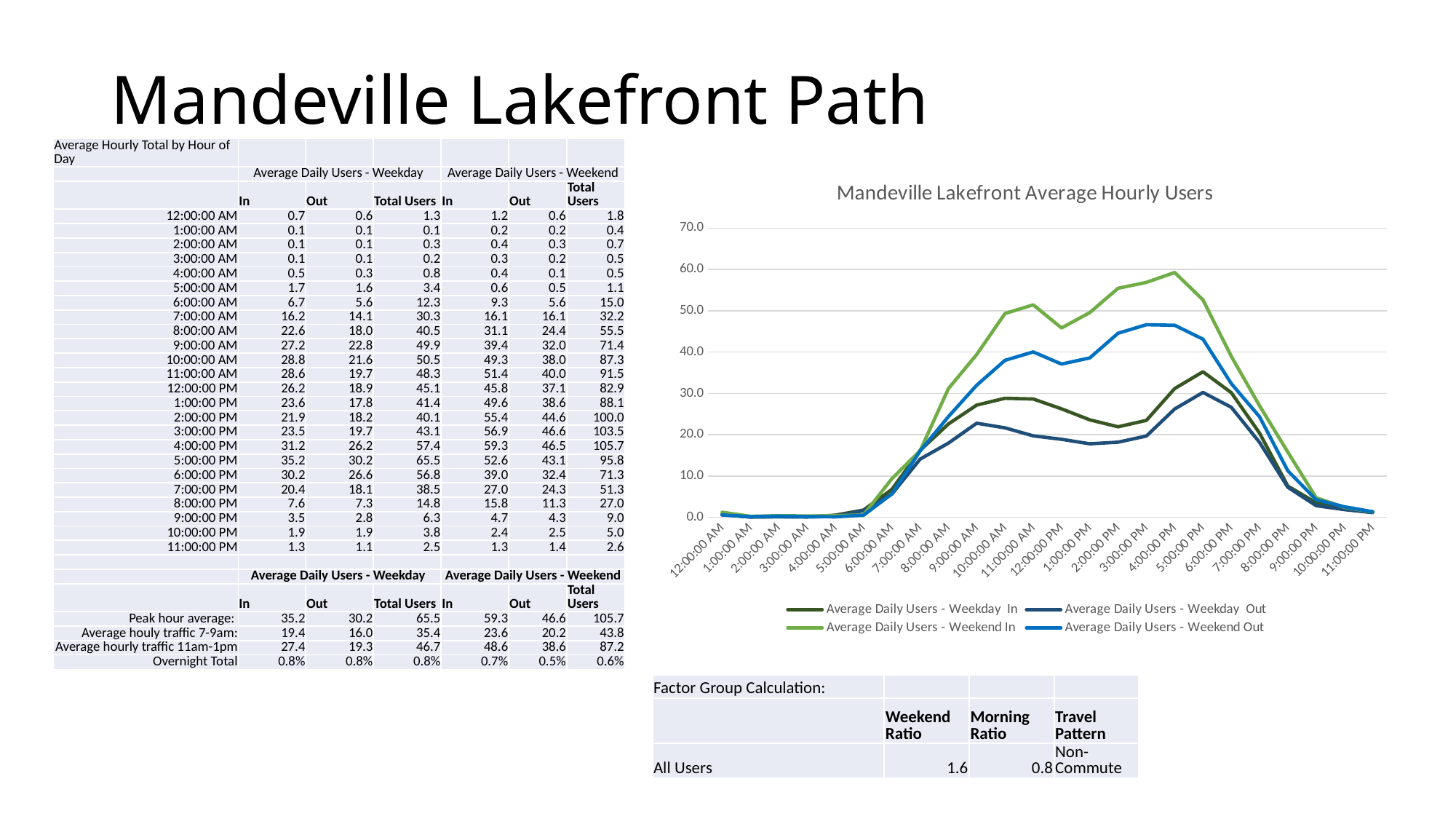
Is the value for Average Daily Users - Weekday Out at 1:00:00 PM greater or less than 20? less Does the Average Daily Users - Weekend In line rise or fall between 5:00:00 PM and 9:00:00 PM? Fall Which series reaches the highest value on the chart? Average Daily Users - Weekend In At which hour does the Average Daily Users - Weekday In line reach its peak? 5:00:00 PM What kind of chart is shown on the slide? Line chart How many series does the chart legend list? 4 At which hour does the Average Daily Users - Weekend In line reach its peak? 4:00:00 PM Is the value for Average Daily Users - Weekend Out at 4:00:00 PM greater or less than 40? greater How many hourly points are plotted along the x axis of the chart? 24 What is the title of the chart? Mandeville Lakefront Average Hourly Users At 10:00:00 AM, which is larger: Average Daily Users - Weekend In or Average Daily Users - Weekday In? Average Daily Users - Weekend In Is the value for Average Daily Users - Weekend In at 4:00:00 PM greater or less than 50? greater